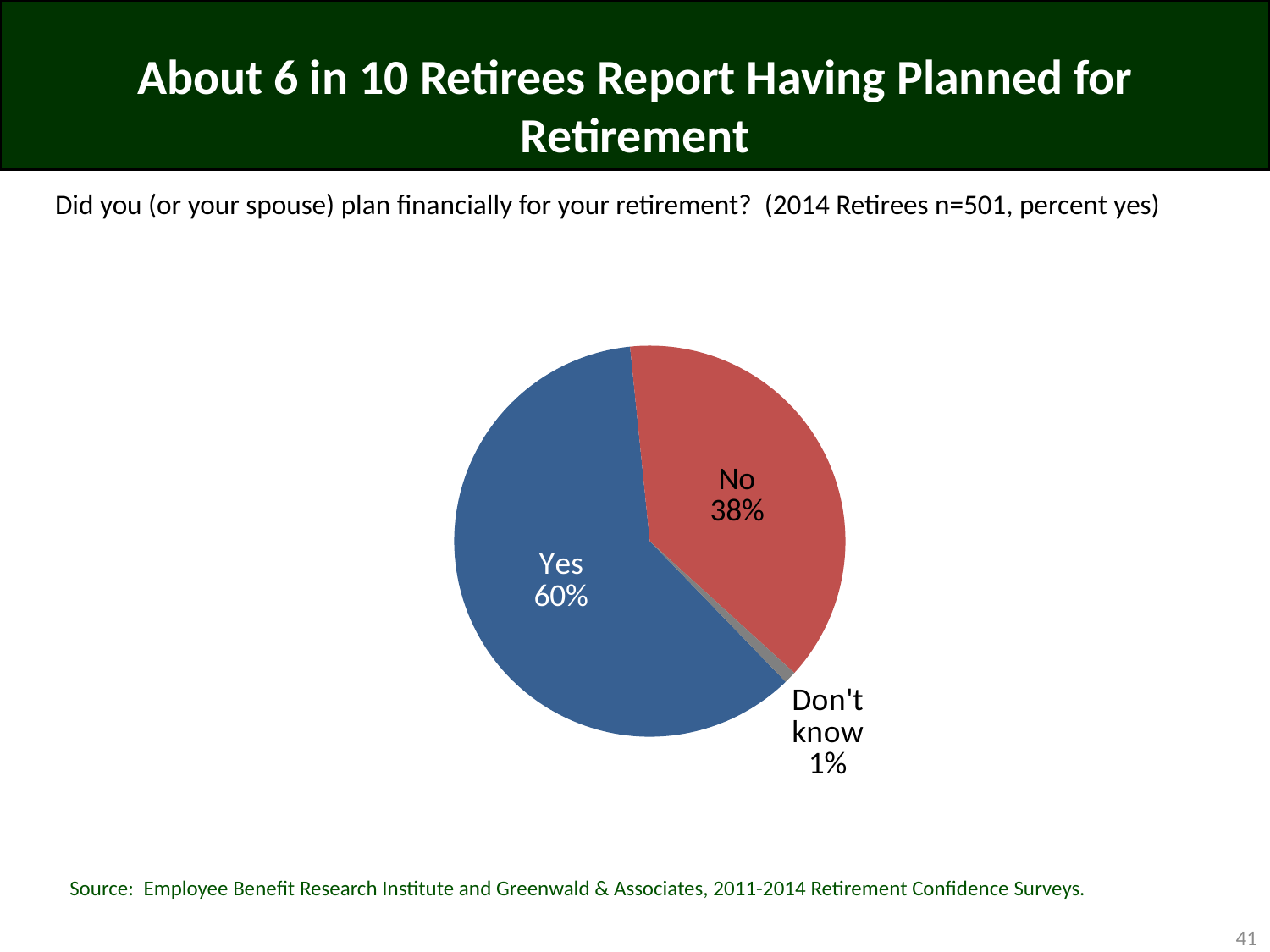
What kind of chart is shown on the slide? pie chart What is the difference in percentage points between the "Yes" and "No" slices? 22 What colour is the "Yes" slice? blue What percentage of retirees answered "Don't know"? 1% Which is larger, the "No" slice or the "Don't know" slice? No How many slices does the pie chart have? 3 What share of the pie does the "No" slice represent? 38% Which response has the smallest share of the pie? Don't know What is the sample size (n) of 2014 retirees stated on the slide? 501 Which response has the largest share of the pie? Yes What percentage of retirees answered "No"? 38% What percentage of retirees answered "Yes"? 60%